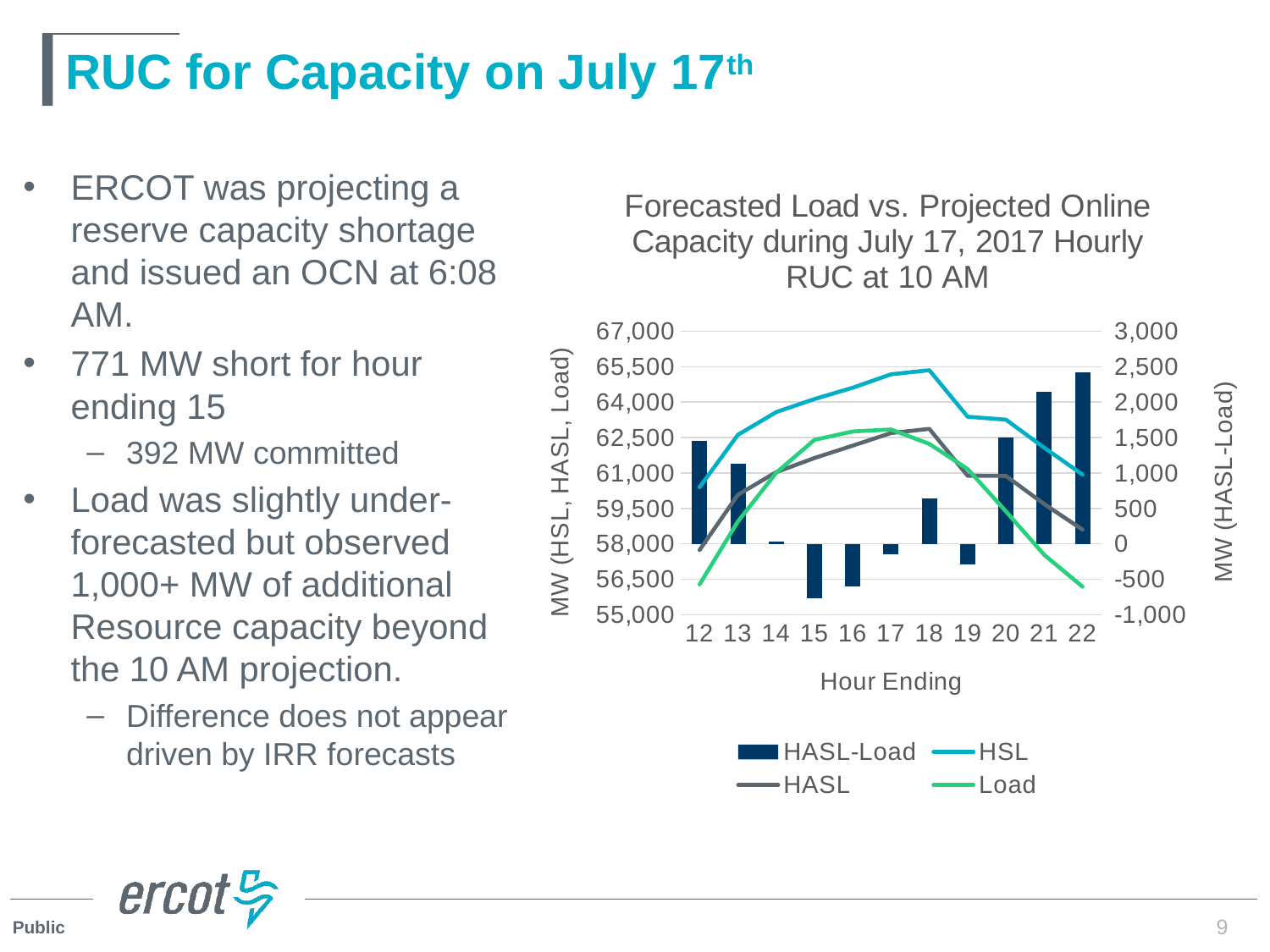
Is the HASL-Load value for hour ending 15 greater or less than -500? less Which is larger at hour ending 21: the HASL-Load bar or the HASL-Load bar at hour ending 13? Hour ending 21 At which hour ending is the HASL-Load bar the highest? 22 What kind of chart is shown on the slide? A combined bar and line chart Is the HSL value for hour ending 18 greater or less than 64,000? greater Is the HASL-Load value for hour ending 12 greater or less than 1,000? greater How many series does the chart legend list? 4 How many hour-ending categories are plotted on the x axis? 11 At which hour ending is the HASL-Load bar the lowest? 15 Does the HSL line rise or fall from hour ending 12 to hour ending 18? rise